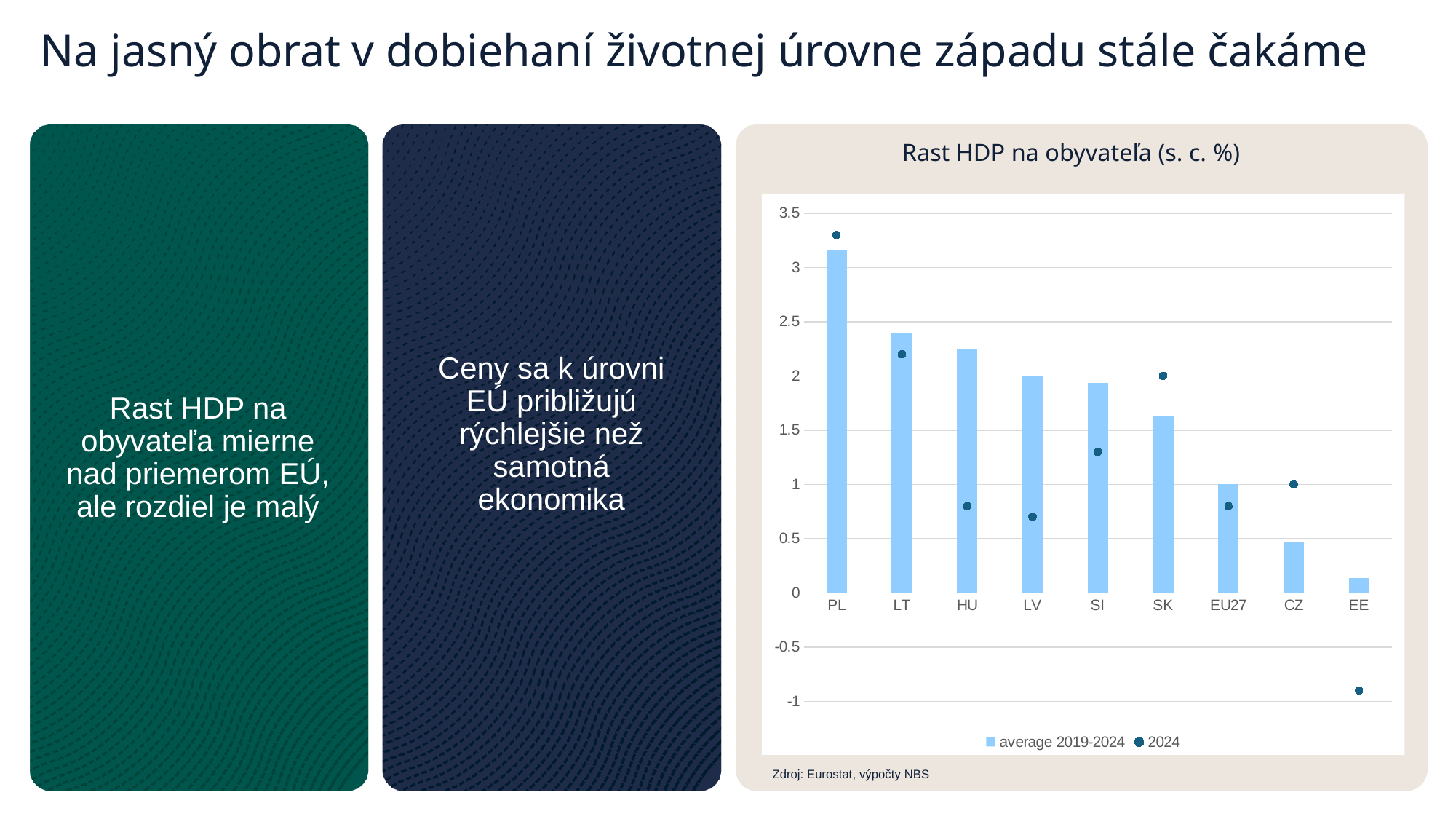
Do the average 2019-2024 bars rise or fall from left to right along the x axis? fall For SK, which is larger: the 2024 value or the average 2019-2024 value? 2024 How many series does the chart legend list? 2 How many countries/categories are shown on the x axis of the chart? 9 Which category has the lowest 2024 value? EE For HU, which is larger: the average 2019-2024 value or the 2024 value? average 2019-2024 What kind of chart is shown on the slide? combination chart (bars with dot markers) Which category has the lowest bar for average 2019-2024? EE Is the average 2019-2024 value for PL greater or less than 3? greater Is the 2024 value for EE greater or less than -0.5? less Which category has the highest bar for average 2019-2024? PL